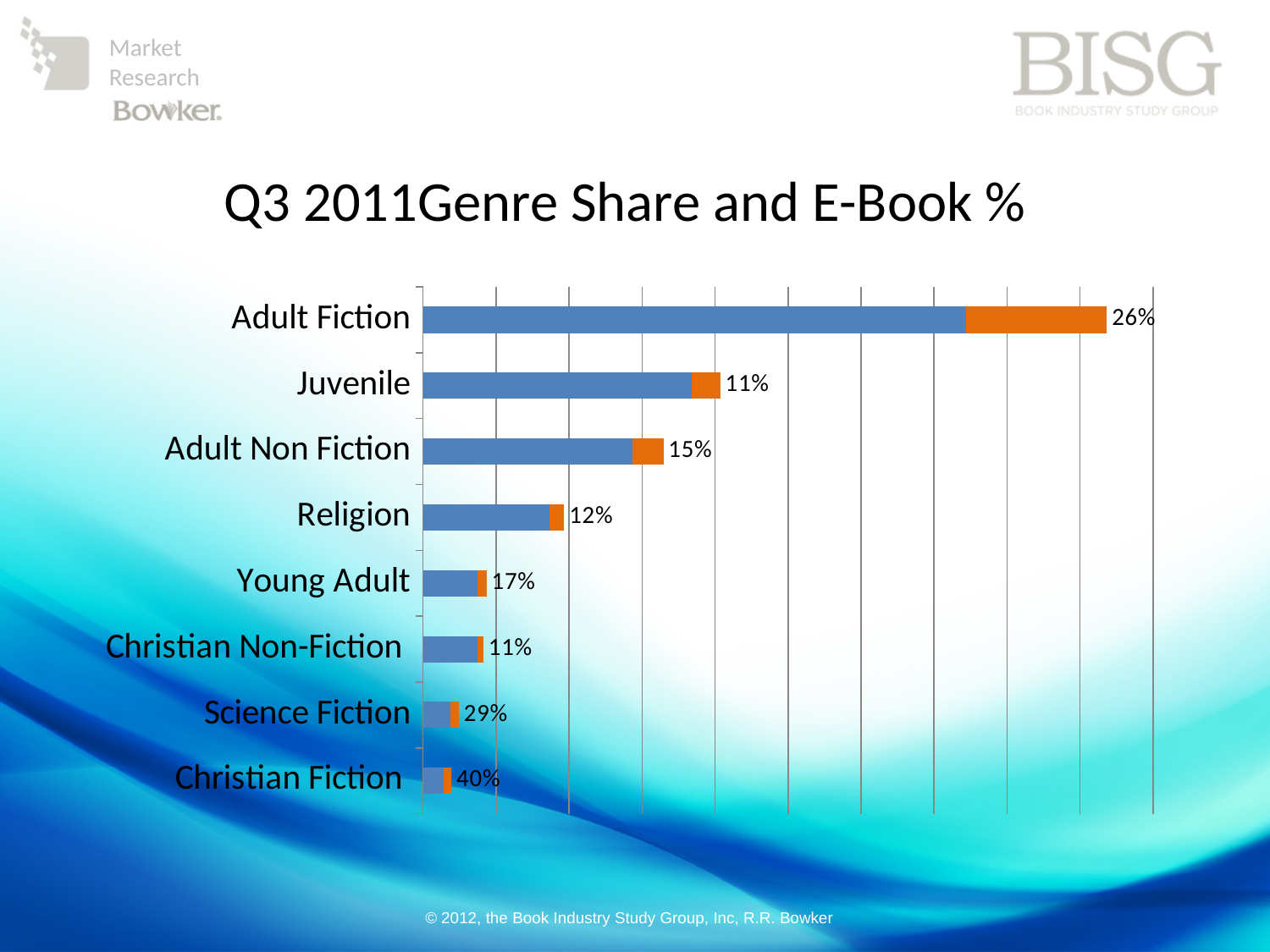
What E-Book % is shown for Christian Fiction? 40% What E-Book % is shown for Young Adult? 17% Which genre has the longest bar in the chart? Adult Fiction What is the difference between the E-Book % for Christian Fiction and Adult Fiction? 14% What E-Book % is shown for Science Fiction? 29% What E-Book % is shown for Religion? 12% What type of chart is shown on the slide? Bar chart What is the title of the chart on the slide? Q3 2011Genre Share and E-Book % Which genre has the highest E-Book % label? Christian Fiction What E-Book % is shown for Adult Fiction? 26% How many genres are shown in the chart? 8 Which has a higher E-Book % label, Adult Non Fiction or Religion? Adult Non Fiction